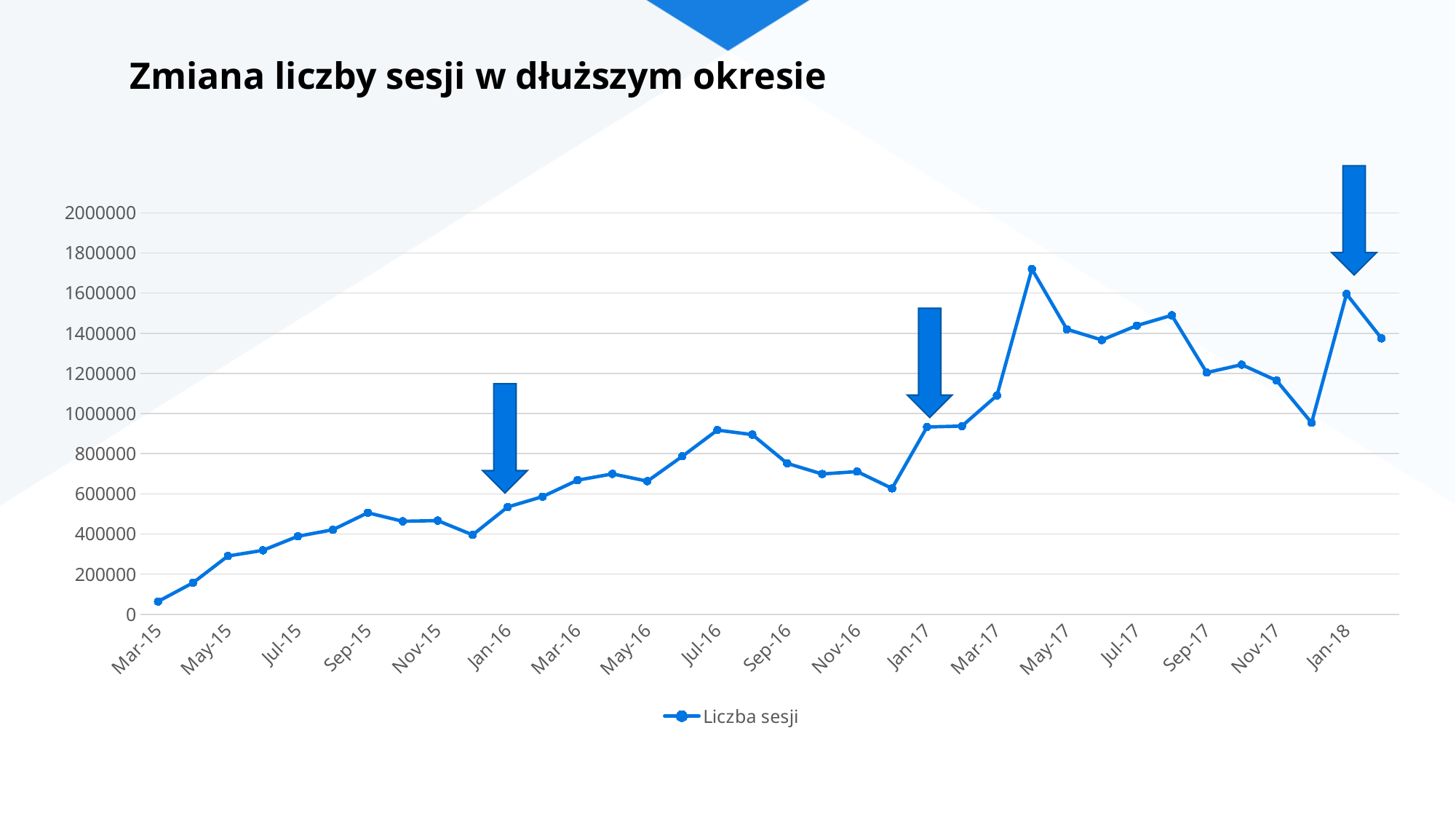
Is the value for Jan-18 greater or less than 1400000? greater What is the name of the series shown in the legend? Liczba sesji Is the value for Mar-15 greater or less than 200000? less Is the value for Jul-16 greater or less than 800000? greater Overall, do the values rise or fall from Mar-15 to Jan-18? rise What kind of chart is shown on the slide? line chart Which is larger, the value for Jul-15 or the value for Jul-16? Jul-16 How many series does the legend list? 1 Which is larger, the value for Jan-17 or the value for Jan-18? Jan-18 What is the title of the chart? Zmiana liczby sesji w dłuższym okresie Which labeled month has the lowest number of sessions? Mar-15